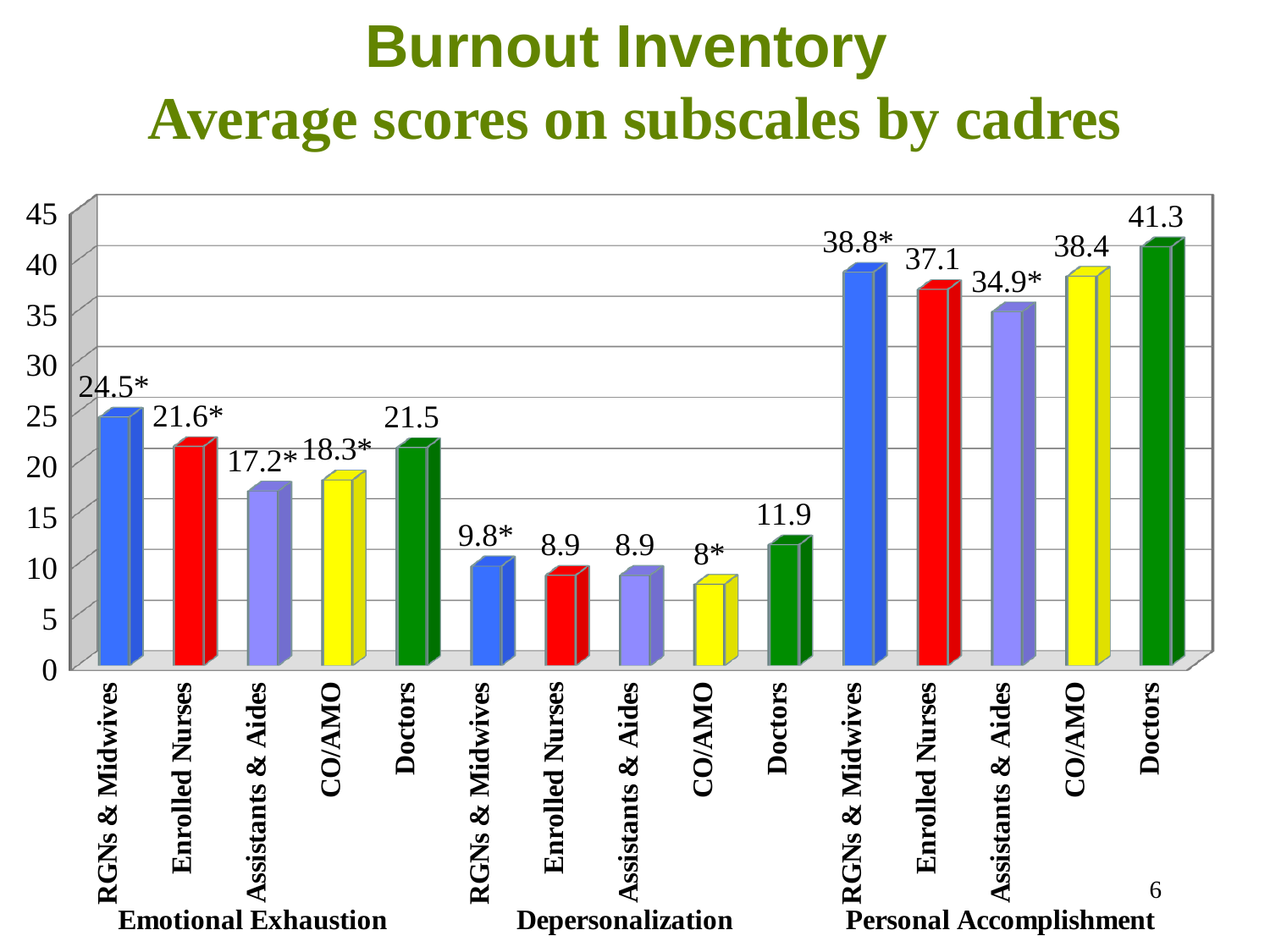
How many subscale groups are shown along the x axis? 3 What is the Emotional Exhaustion score for Doctors? 21.5 What is the maximum value shown on the vertical axis? 45 What is the Personal Accomplishment score for Enrolled Nurses? 37.1 Which cadre has the lowest Emotional Exhaustion score? Assistants & Aides Which is larger, the Emotional Exhaustion score for RGNs & Midwives or for Enrolled Nurses? RGNs & Midwives How many bars are plotted in the chart? 15 What is the Depersonalization score for CO/AMO? 8* What kind of chart is shown on the slide? Bar chart What is the difference between the Personal Accomplishment scores of Doctors and Assistants & Aides? 6.4 Is the Depersonalization score for Doctors greater or less than 10? greater Which cadre has the highest Personal Accomplishment score? Doctors